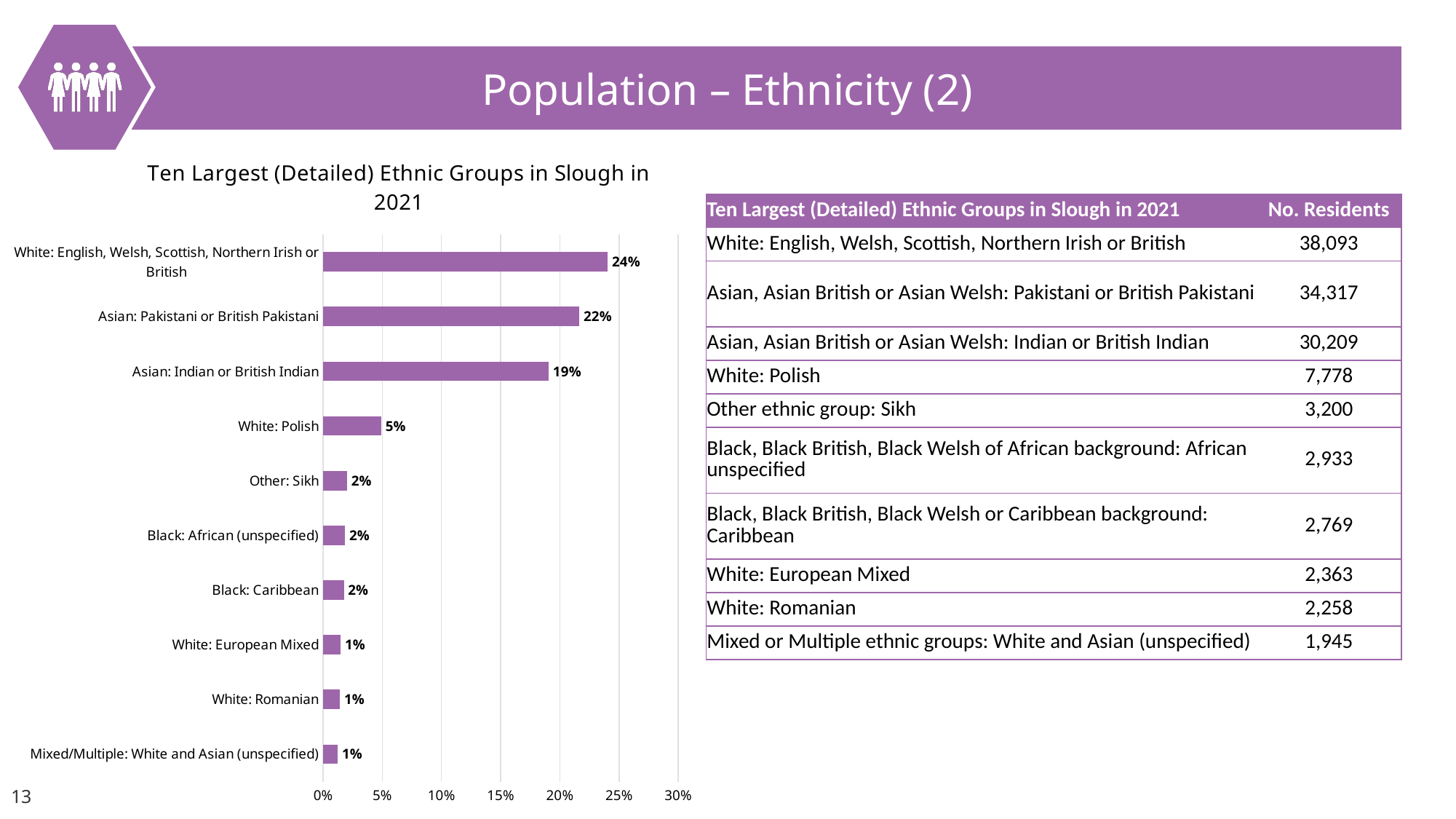
What is the title of the chart? Ten Largest (Detailed) Ethnic Groups in Slough in 2021 What is the value for White: Polish in the chart? 5% Is the value for White: English, Welsh, Scottish, Northern Irish or British greater or less than 20%? greater Which is larger, the value for Asian: Indian or British Indian or the value for White: Polish? Asian: Indian or British Indian Which ethnic group has the highest value in the chart? White: English, Welsh, Scottish, Northern Irish or British What is the value for Asian: Pakistani or British Pakistani in the chart? 22% What is the value for Asian: Indian or British Indian in the chart? 19% What is the difference between the values for White: English, Welsh, Scottish, Northern Irish or British and Asian: Pakistani or British Pakistani? 2% How many ethnic groups are shown in the chart? 10 What is the difference between the values for Asian: Pakistani or British Pakistani and White: Polish? 17% What kind of chart is shown on the slide? Bar chart Is the value for White: Polish greater or less than 10%? less